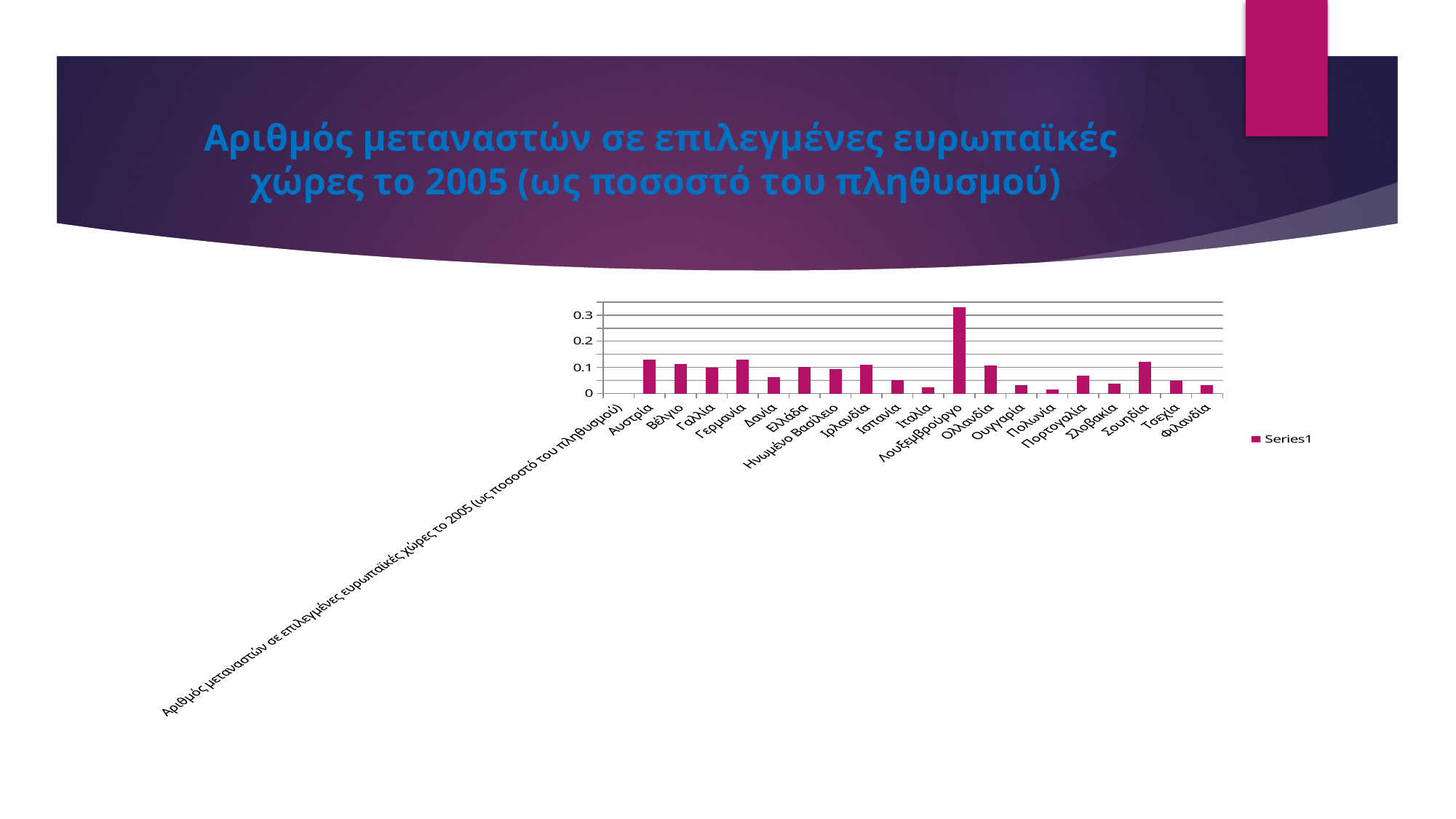
What kind of chart is shown on the slide? Bar chart How many series does the legend list? 1 Is the value for Αυστρία greater or less than 0.1? greater Which has a larger value, Λουξεμβούργο or Ολλανδία? Λουξεμβρούργο Is the value for Ιταλία greater or less than 0.1? less Which country has the highest value in the chart? Λουξεμβρούργο Which has a larger value, Γερμανία or Δανία? Γερμανία What is the name of the series shown in the legend? Series1 Is the value for Σουηδία greater or less than 0.1? greater Which has a larger value, Ιρλανδία or Ισπανία? Ιρλανδία